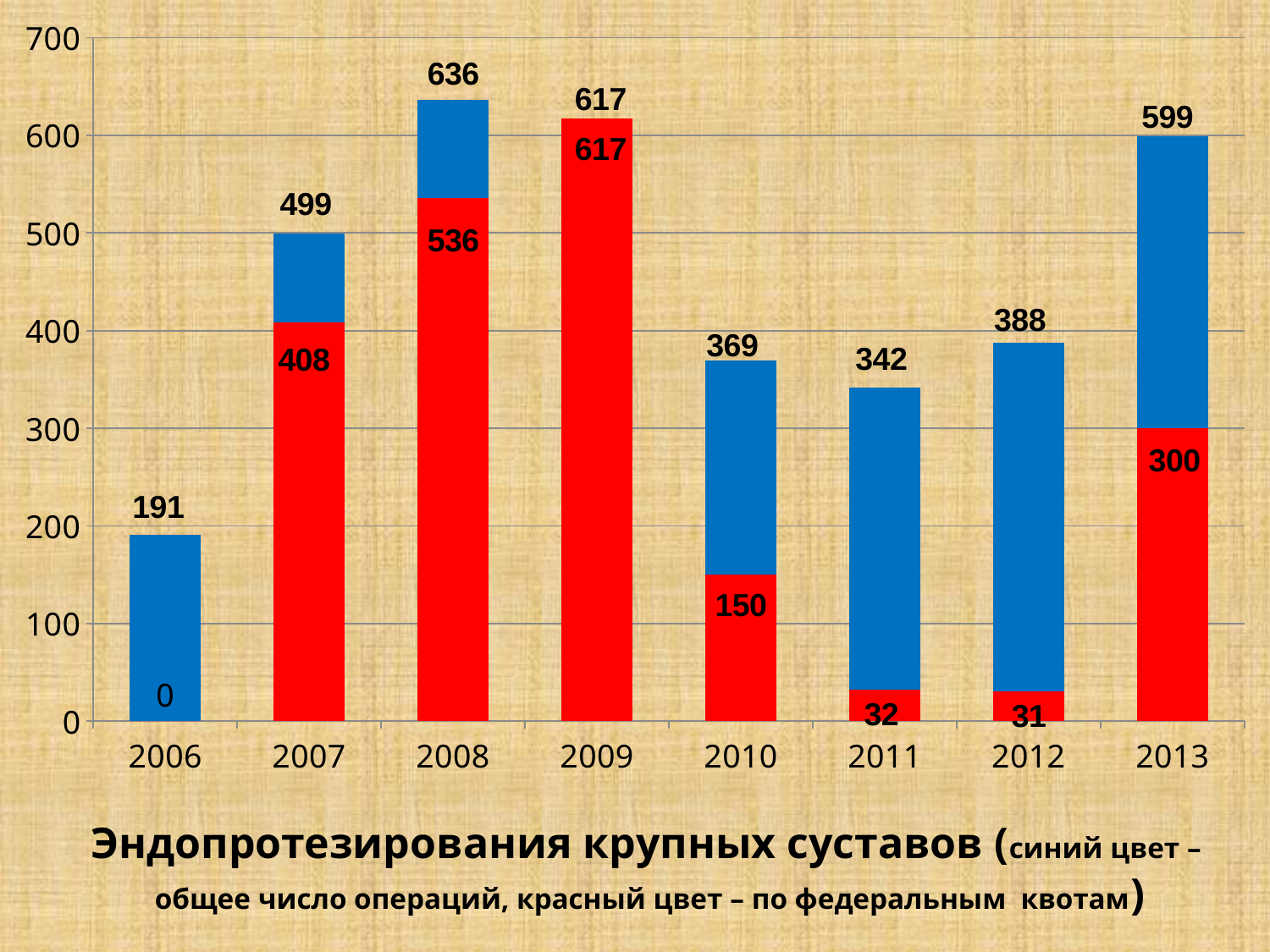
Which is larger: the total number of operations in 2010 or in 2012? 2012 What kind of chart is shown on the slide? bar chart What was the total number of large-joint endoprosthesis operations (blue) in 2008? 636 How many operations were performed under federal quotas (red) in 2007? 408 According to the caption, what does the red colour represent? operations under federal quotas (по федеральным квотам) Is the total number of operations in 2011 greater or less than 400? less How many years are shown on the x axis? 8 How many operations under federal quotas (red) are shown for 2006? 0 What is the difference between the total number of operations and the federal-quota operations in 2008? 100 Which year has the lowest total number of operations (blue)? 2006 Which year has the highest total number of operations (blue)? 2008 What is the difference between the total number of operations and the federal-quota operations in 2013? 299